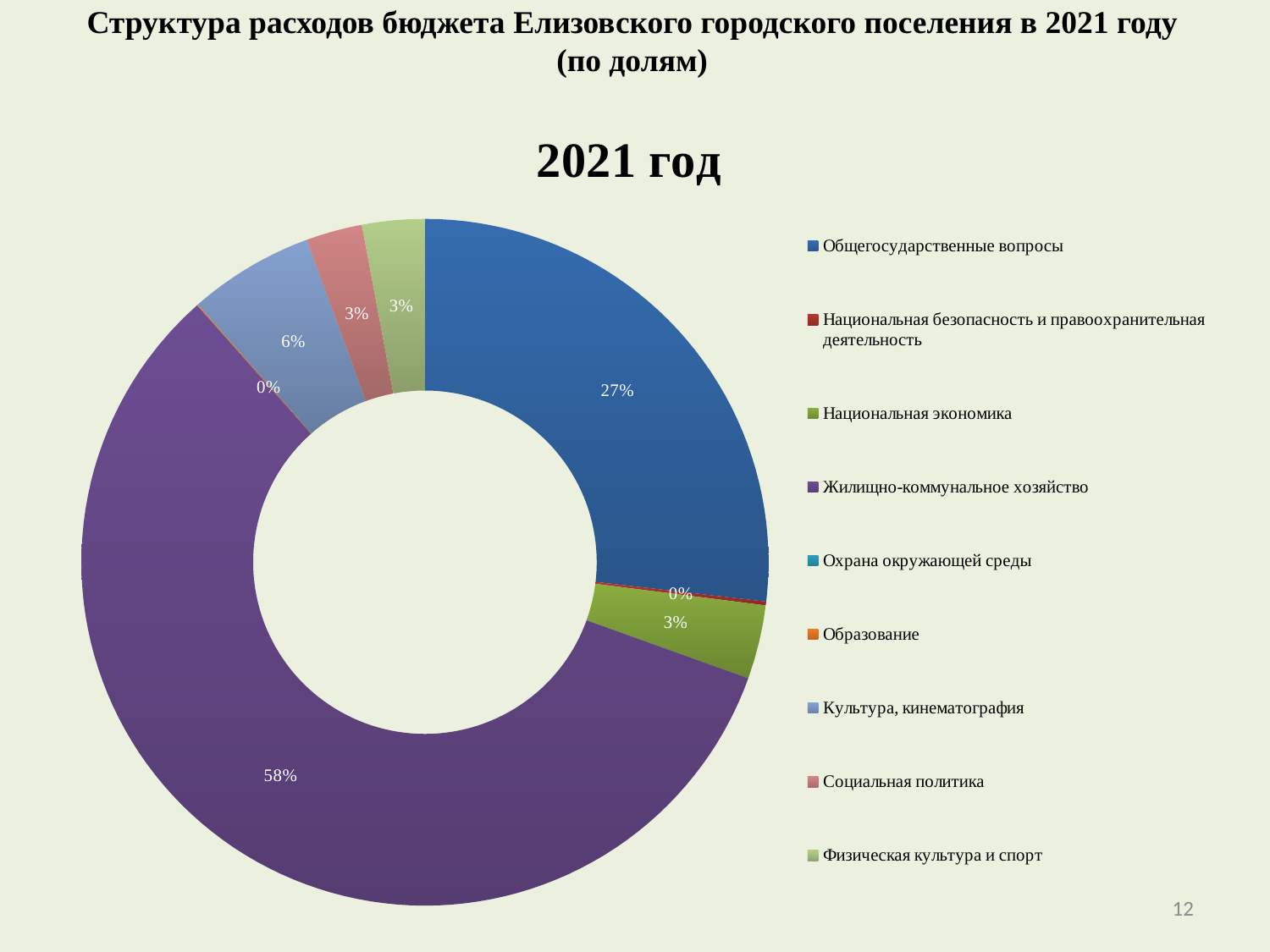
What is the title shown directly above the chart? 2021 год What share of the 2021 budget expenditures goes to Социальная политика? 3% Which expenditure category has the largest share in the 2021 chart? Жилищно-коммунальное хозяйство Which has the larger share: Культура, кинематография or Социальная политика? Культура, кинематография What kind of chart is shown on the slide? Doughnut (pie) chart What share of the 2021 budget expenditures goes to Жилищно-коммунальное хозяйство? 58% By how many percentage points does the share of Жилищно-коммунальное хозяйство exceed the share of Общегосударственные вопросы? 31 percentage points What share of the 2021 budget expenditures goes to Национальная экономика? 3% What share of the 2021 budget expenditures goes to Физическая культура и спорт? 3% What share of the 2021 budget expenditures goes to Культура, кинематография? 6% What share of the 2021 budget expenditures goes to Общегосударственные вопросы? 27% How many expenditure categories does the legend list? 9